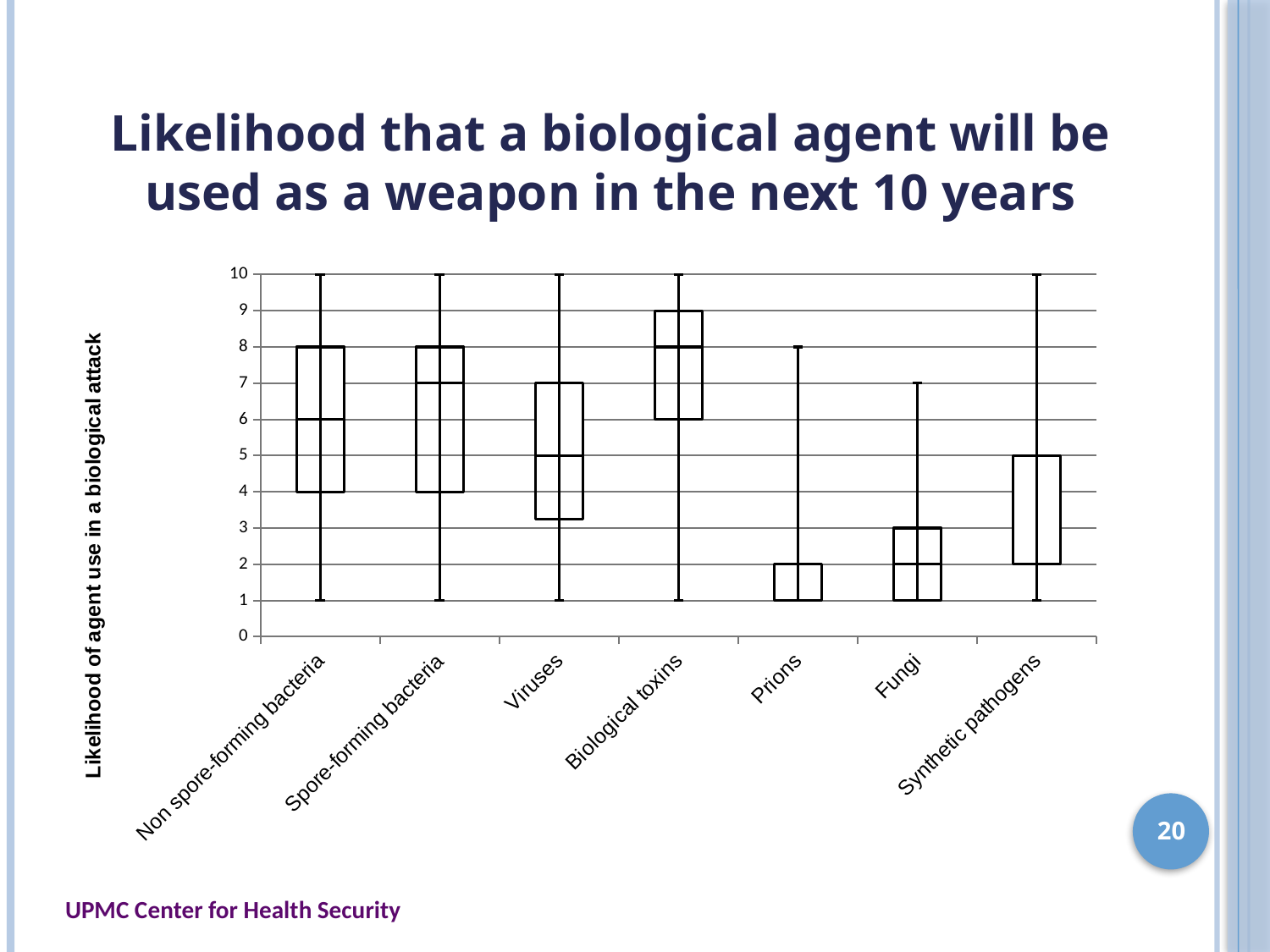
What is the top of the upper whisker for Fungi? 7 What is the median likelihood value for Biological toxins? 8 What is the label on the y axis of the chart? Likelihood of agent use in a biological attack Which has a higher median likelihood, Non spore-forming bacteria or Fungi? Non spore-forming bacteria Which category has the highest median likelihood? Biological toxins What is the top of the upper whisker for Prions? 8 What kind of chart is shown on the slide? Box-and-whisker plot What is the difference between the median likelihood for Biological toxins and the median for Fungi? 6 Which category has the lowest box (interquartile range) on the chart? Prions How many biological agent categories are shown on the x axis? 7 What is the median likelihood value for Spore-forming bacteria? 7 Is the median likelihood for Viruses greater or less than 6? less